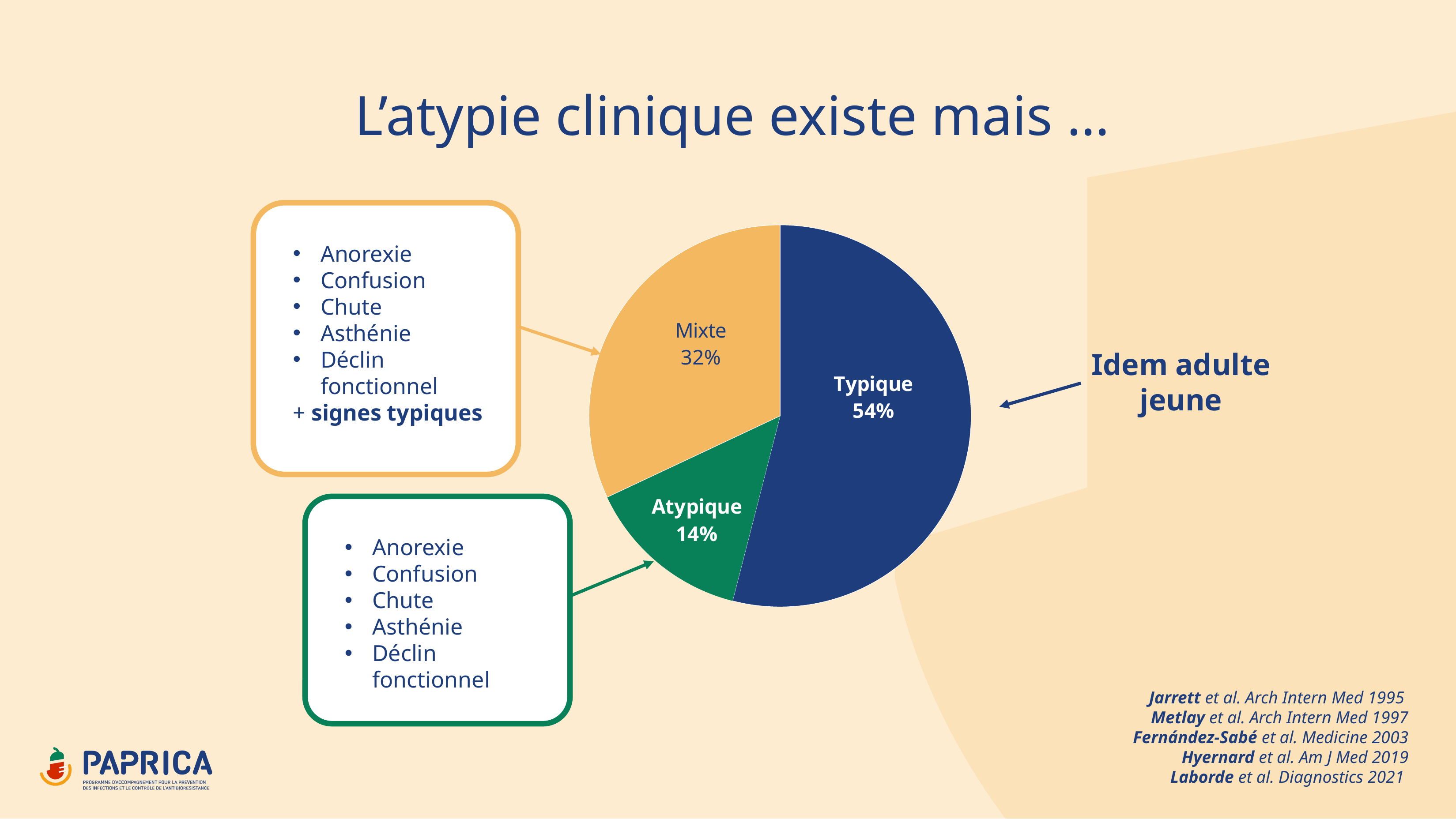
What kind of chart is shown on the slide? pie chart Which slice of the pie is the smallest? Atypique What is the value for the Atypique slice? 14% What colour is the Typique slice? dark blue Which slice of the pie is the largest? Typique What colour is the Atypique slice? green How many slices does the pie chart have? 3 What is the difference between the Mixte and Atypique slices? 18% What is the value for the Typique slice? 54% Which is larger, the Mixte slice or the Atypique slice? Mixte What is the difference between the Typique and Mixte slices? 22% What is the value for the Mixte slice? 32%